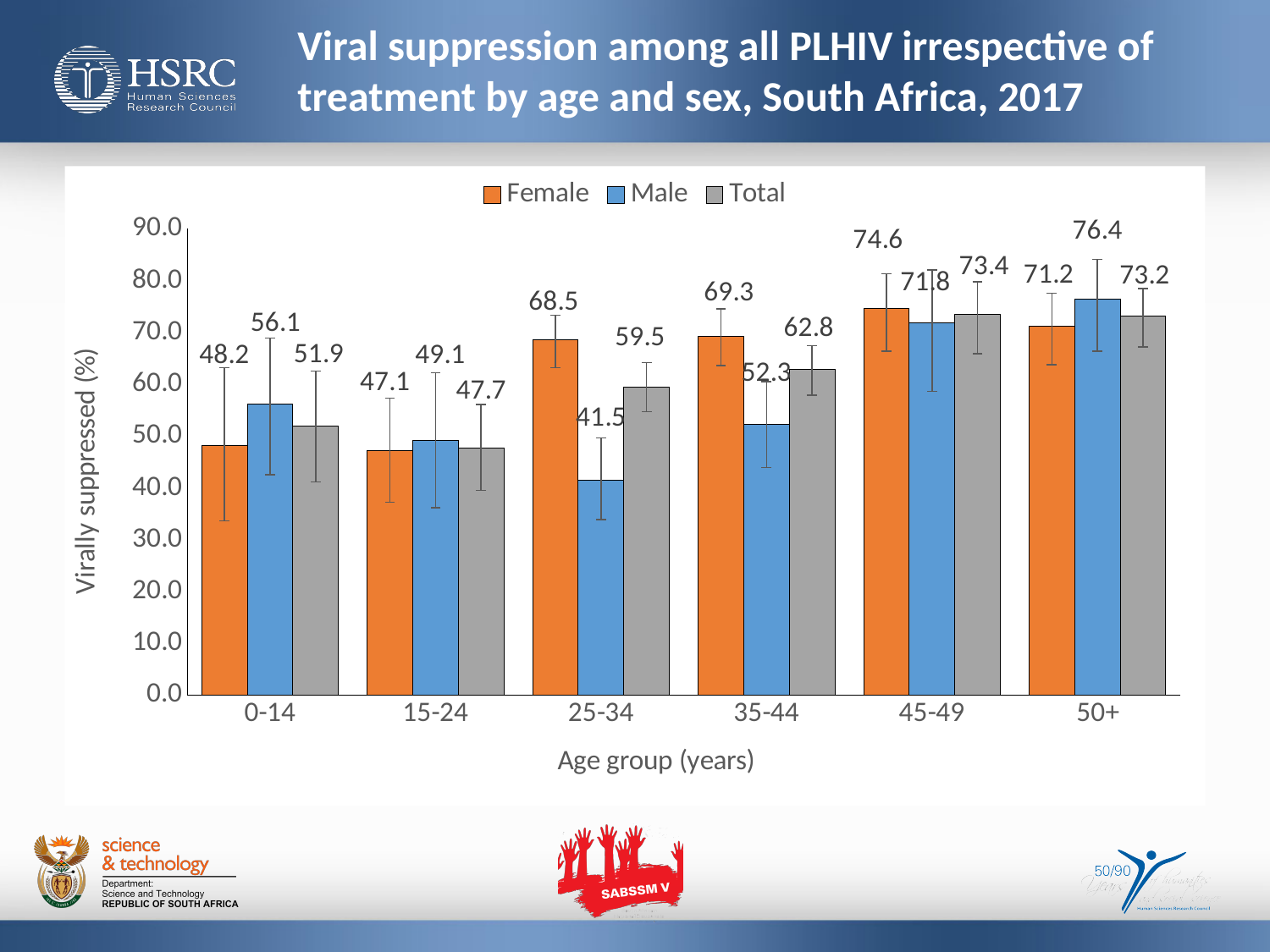
Do the Total values rise or fall from the 15-24 age group to the 45-49 age group? Rise What is the Male value for the 0-14 age group? 56.1 Which age group has the lowest Male value? 25-34 What kind of chart is shown on the slide? Bar chart Which age group has the highest Female value? 45-49 What is the Female value for the 50+ age group? 71.2 What is the Total value for the 35-44 age group? 62.8 How many series does the legend list? 3 For the 0-14 age group, which is larger, the Female value or the Male value? Male How many age groups are shown on the x axis? 6 What is the difference between the Female and Male values for the 25-34 age group? 27.0 What is the Female value for the 25-34 age group? 68.5